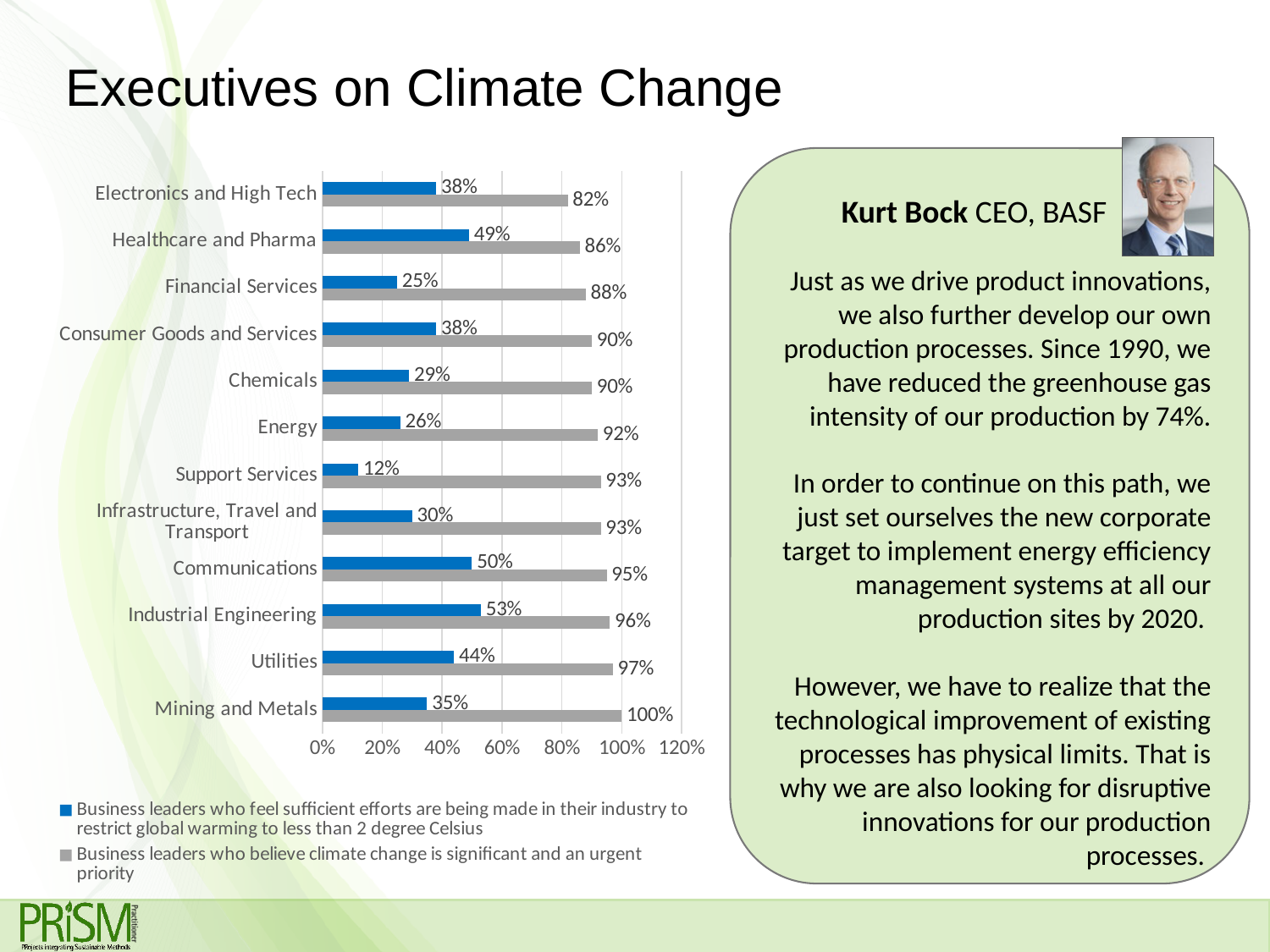
What type of chart is shown on the slide? Bar chart How many series does the legend list? 2 Which is larger: the percentage of Communications leaders or Healthcare and Pharma leaders who feel sufficient efforts are being made to restrict global warming? Communications What percentage of business leaders in Energy believe climate change is significant and an urgent priority? 92% Which industry has the highest percentage of business leaders who feel sufficient efforts are being made to restrict global warming to less than 2 degree Celsius? Industrial Engineering Which industry has the highest percentage of business leaders who believe climate change is significant and an urgent priority? Mining and Metals Which industry has the lowest percentage of business leaders who feel sufficient efforts are being made to restrict global warming to less than 2 degree Celsius? Support Services What percentage of business leaders in Financial Services feel sufficient efforts are being made in their industry to restrict global warming to less than 2 degree Celsius? 25% What percentage of business leaders in Electronics and High Tech believe climate change is significant and an urgent priority? 82% How many industries are shown in the chart? 12 What colour represents business leaders who believe climate change is significant and an urgent priority? Grey What is the difference between the percentage of Utilities leaders who believe climate change is an urgent priority and the percentage who feel sufficient efforts are being made? 53%